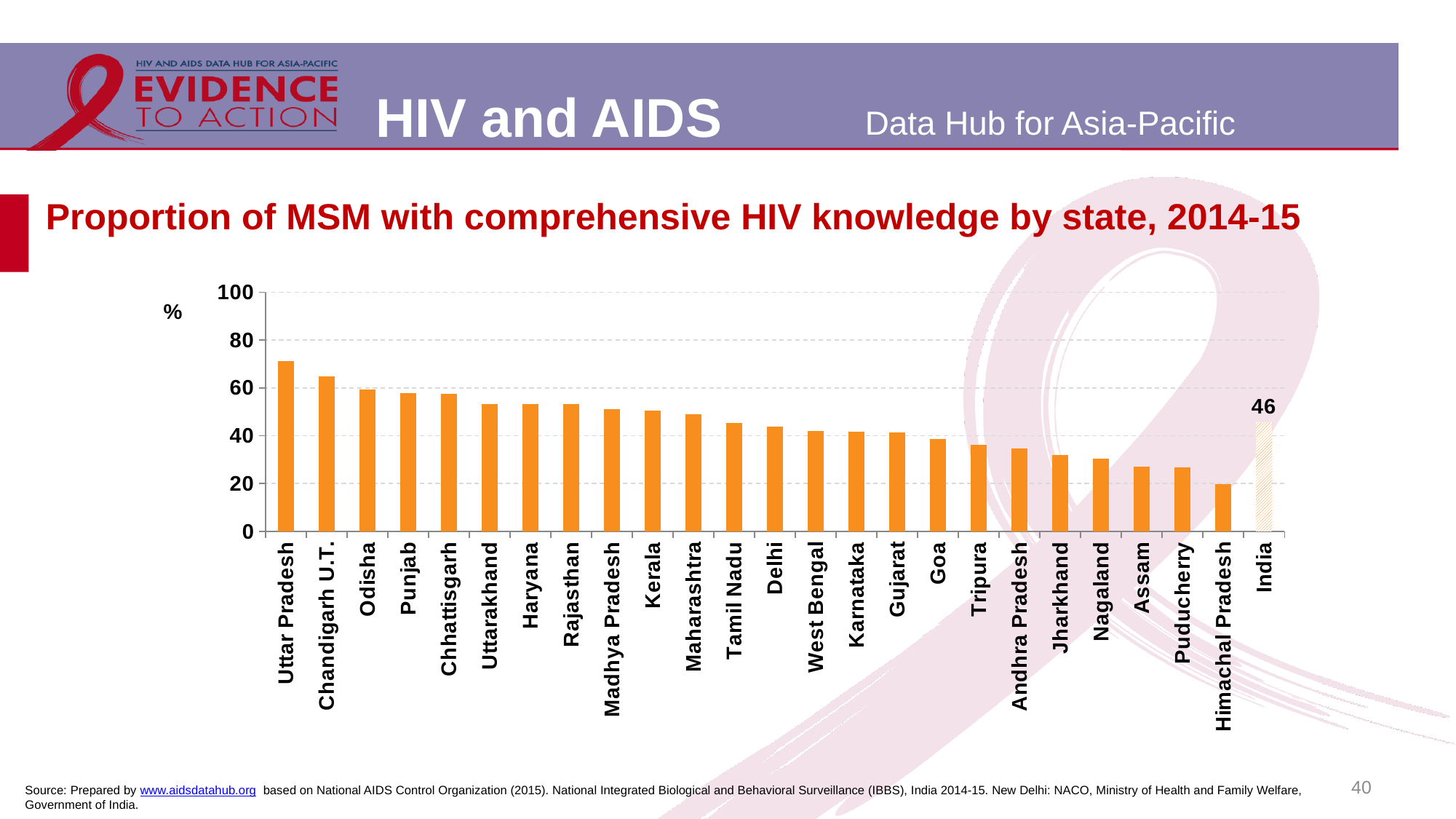
Do the state values rise or fall from left to right across the chart (excluding the India bar)? Fall What kind of chart is shown on the slide? Bar chart Which has a higher value, Puducherry or Chandigarh U.T.? Chandigarh U.T. Which state has the lowest proportion of MSM with comprehensive HIV knowledge? Himachal Pradesh Which has a higher value, Odisha or Assam? Odisha What value is labelled for India? 46 Is the value for Delhi greater or less than 60? less Is the value for Uttar Pradesh greater or less than 60? greater Is the value for Assam greater or less than 40? less Which state has the highest proportion of MSM with comprehensive HIV knowledge? Uttar Pradesh How many bars are shown in the chart, including India? 25